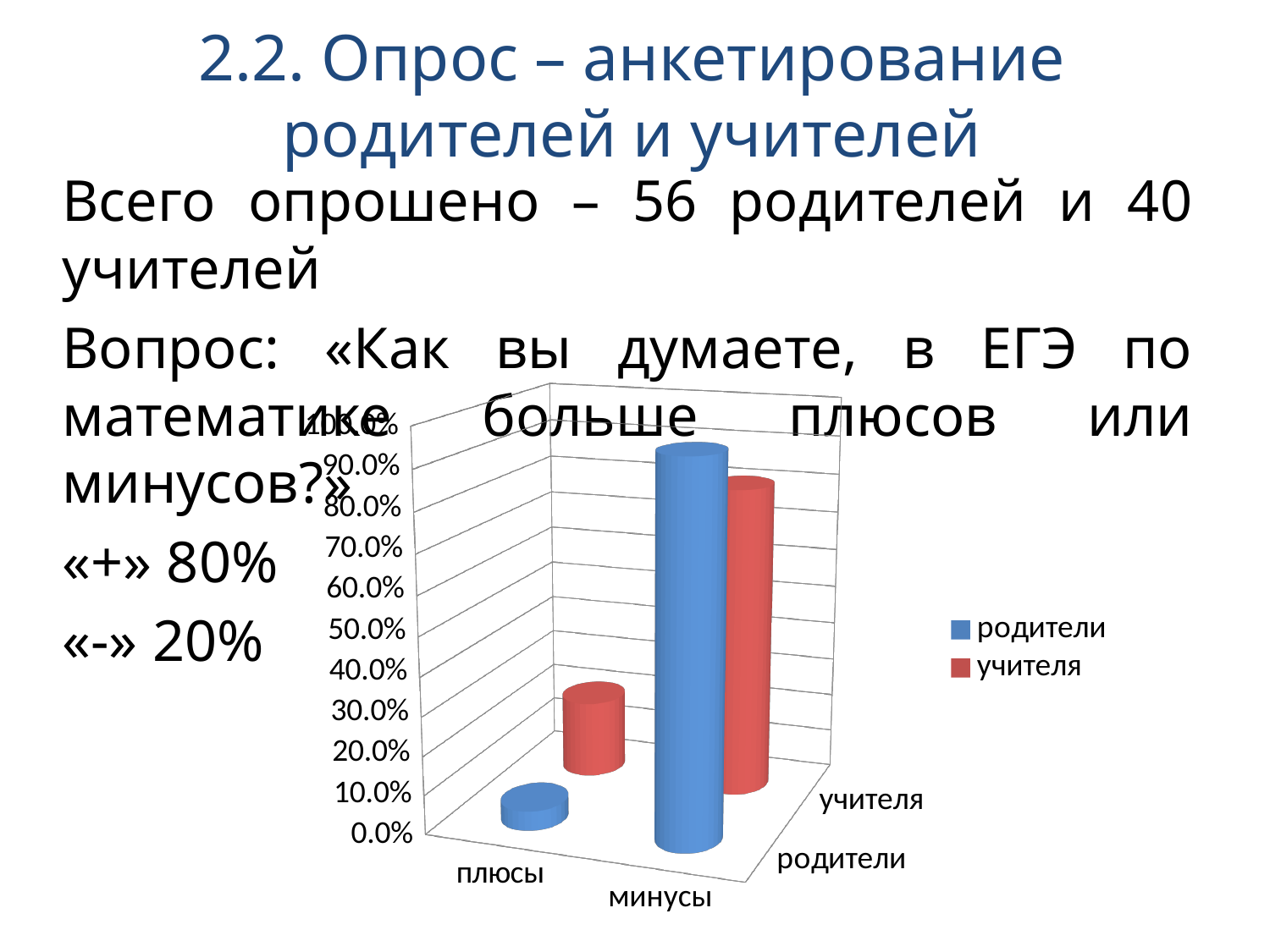
For the родители series, which category has the larger value, плюсы or минусы? минусы How many categories are shown on the chart's x axis? 2 Is the value for родители in the плюсы category greater or less than 30.0%? less What are the two categories on the chart's x axis? плюсы, минусы What are the two series named in the chart legend? родители, учителя Is the value for учителя in the плюсы category greater or less than 50.0%? less Is the value for родители in the минусы category greater or less than 50.0%? greater What kind of chart is shown on the slide? bar chart In the плюсы category, which series has the larger value, родители or учителя? учителя How many series does the chart legend list? 2 For the учителя series, which category has the larger value, плюсы or минусы? минусы